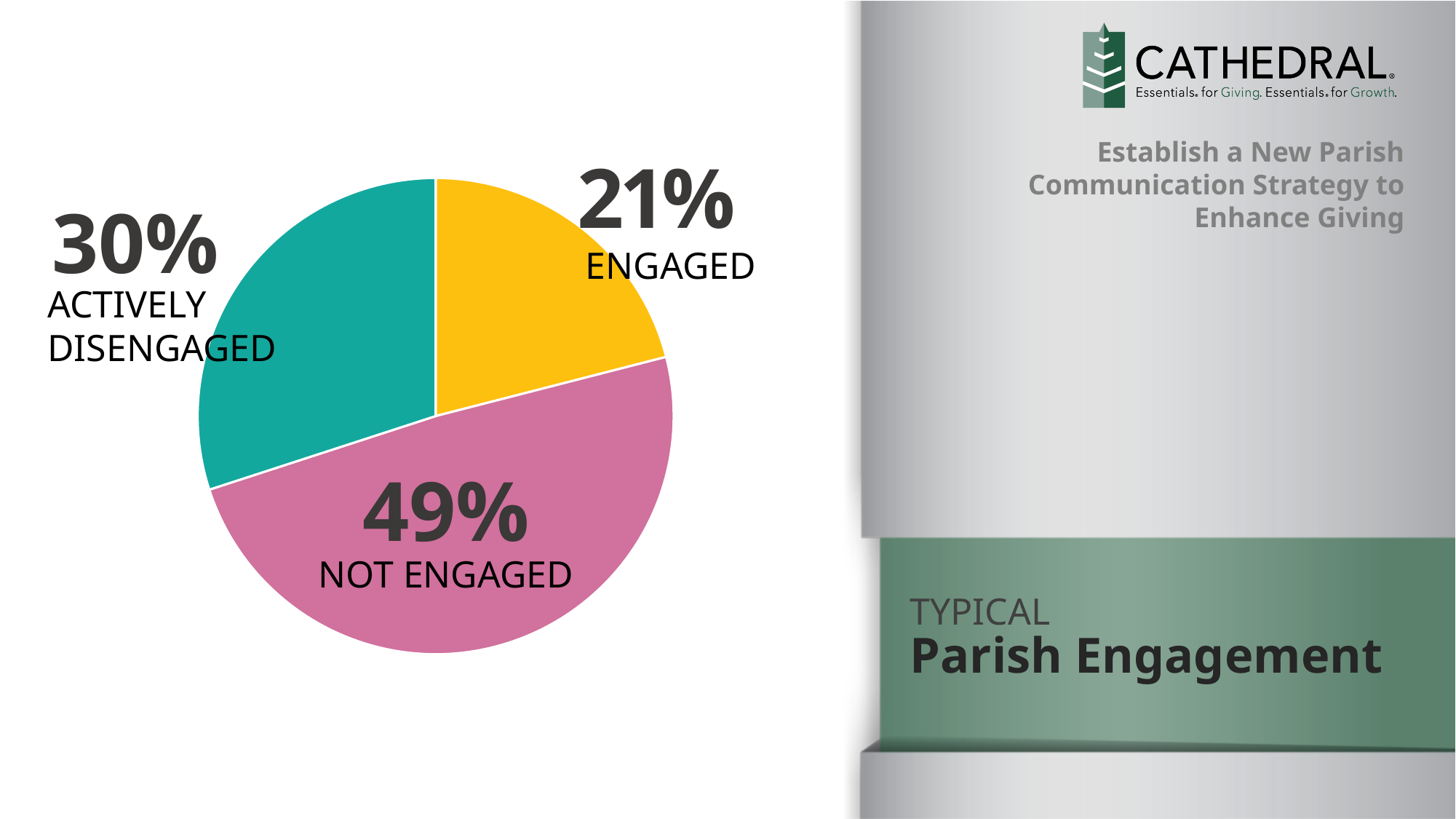
What is the difference in percentage points between Not Engaged and Engaged? 28 What colour is the Not Engaged slice? pink What is the difference in percentage points between Actively Disengaged and Engaged? 9 What percentage of the parish is Not Engaged? 49% What kind of chart is shown on the slide? pie chart What percentage of the parish is Engaged? 21% Which category has the largest share of the pie? Not Engaged How many slices does the pie chart have? 3 Which category has the smallest share of the pie? Engaged What is the title shown in the green band on the slide? Typical Parish Engagement What percentage of the parish is Actively Disengaged? 30% Which is larger, the Actively Disengaged share or the Engaged share? Actively Disengaged